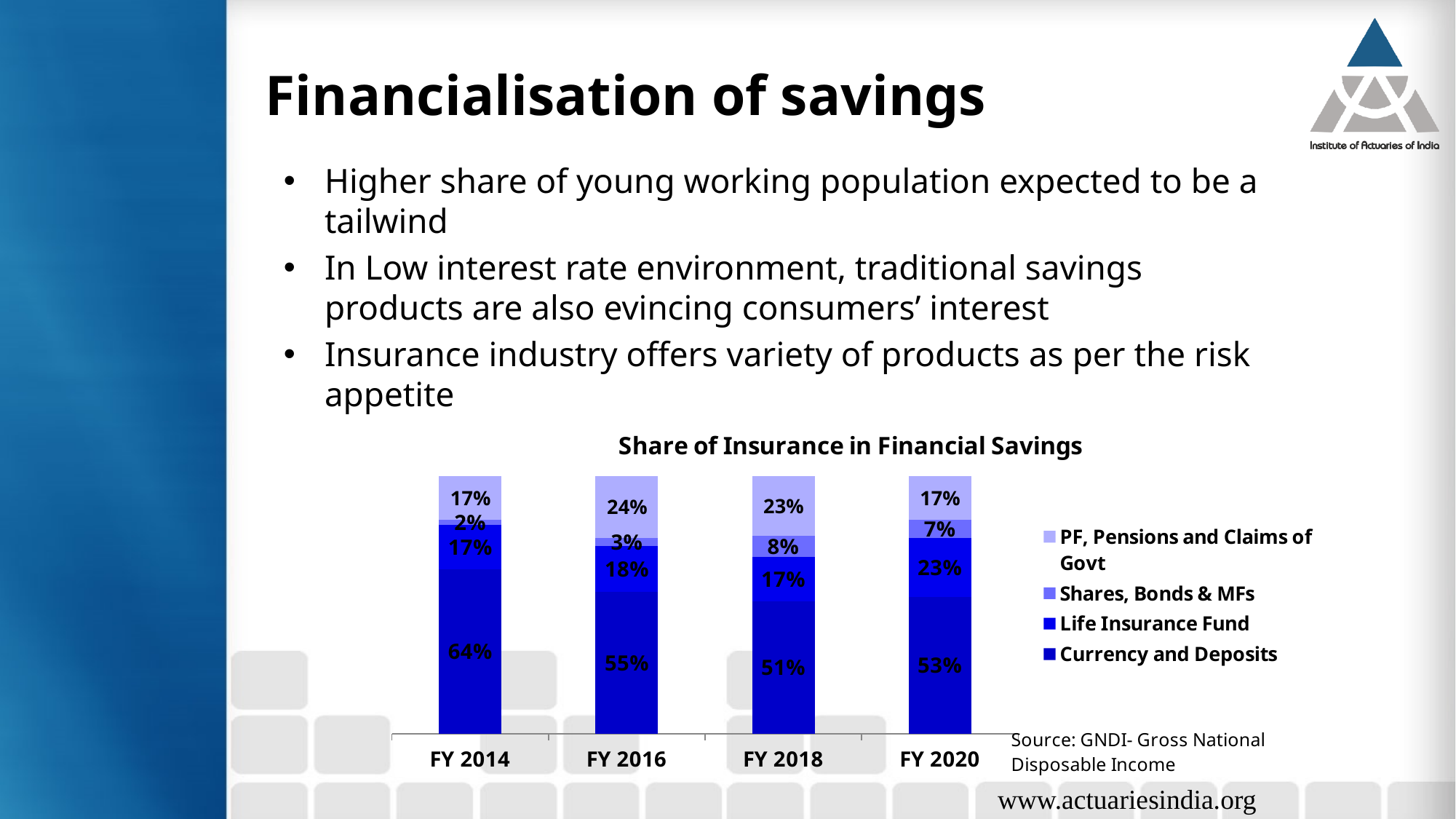
What is the value for PF, Pensions and Claims of Govt in FY 2016? 24% What is the title of the chart? Share of Insurance in Financial Savings What is the value for Life Insurance Fund in FY 2020? 23% What is the difference between the Currency and Deposits share in FY 2014 and in FY 2020? 11% In which fiscal year is the Shares, Bonds & MFs share lowest? FY 2014 What is the value for Shares, Bonds & MFs in FY 2018? 8% In which fiscal year is the Currency and Deposits share highest? FY 2014 How many fiscal years are shown on the x axis? 4 Which is larger: the Life Insurance Fund share in FY 2016 or in FY 2020? FY 2020 What is the value for Currency and Deposits in FY 2014? 64% How many series does the legend list? 4 What kind of chart is shown on the slide? Stacked bar chart